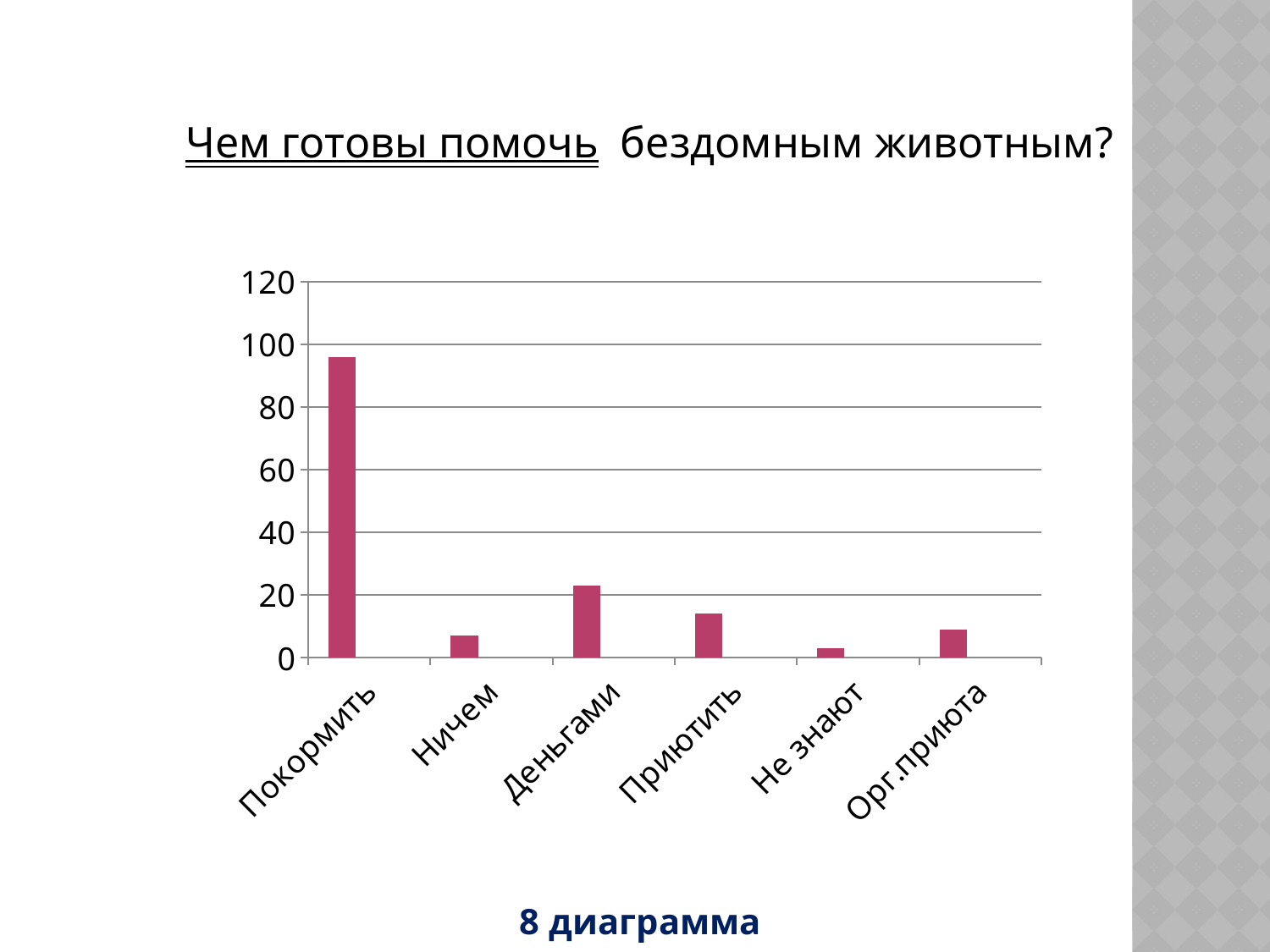
What is the highest value shown on the vertical axis of the chart? 120 Is the value for Деньгами greater or less than 40? less What caption appears below the chart? 8 диаграмма Which has the larger value, Ничем or Не знают? Ничем What kind of chart is shown on the slide? bar chart How many categories are shown on the x axis of the chart? 6 Which category has the highest value in the chart? Покормить Which has the larger value, Деньгами or Приютить? Деньгами Is the value for Покормить greater or less than 80? greater Which category has the lowest value in the chart? Не знают Is the value for Приютить greater or less than 20? less